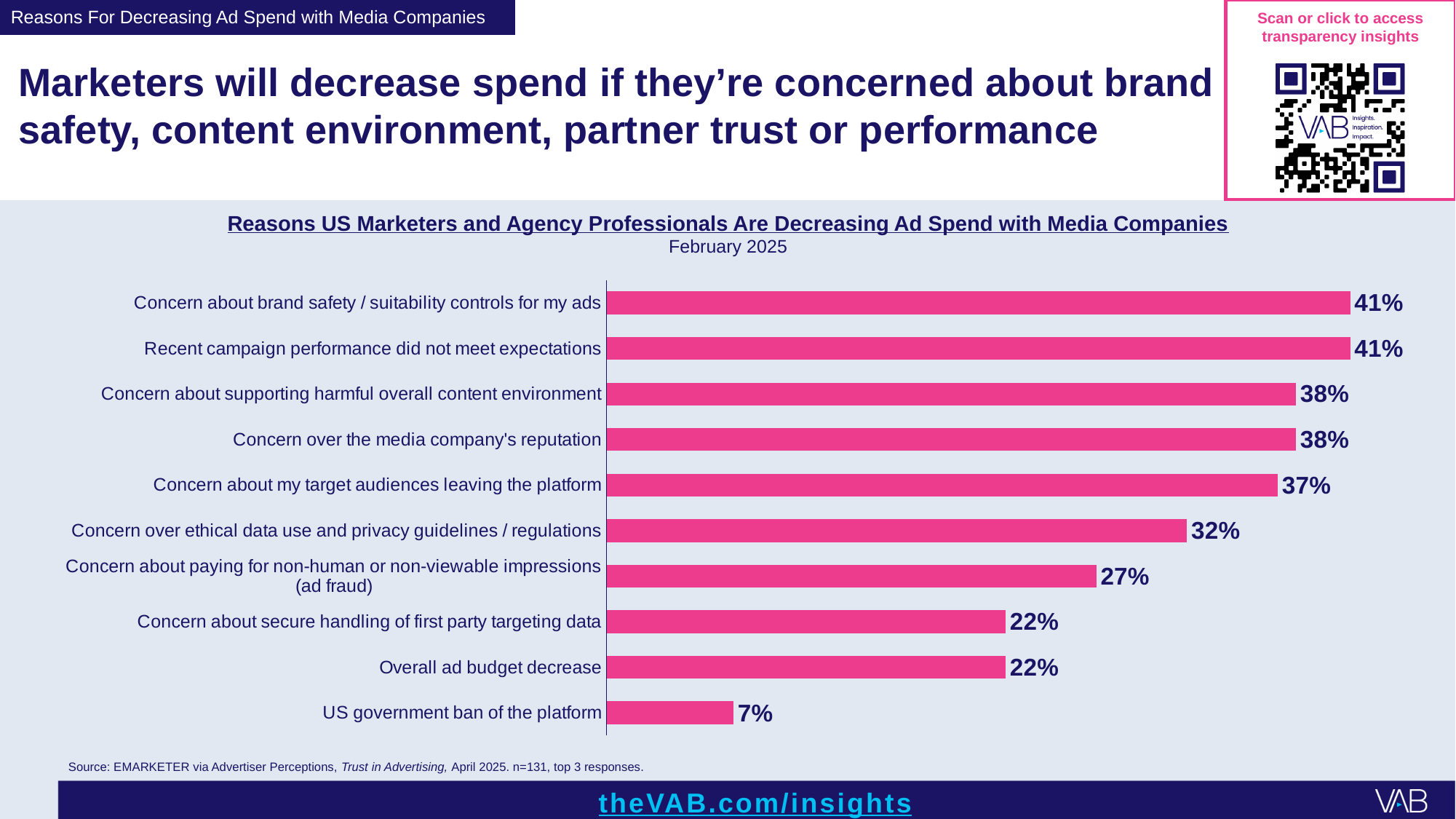
How many reasons (categories) are shown on the chart? 10 What is the value for 'Concern about paying for non-human or non-viewable impressions (ad fraud)'? 27% Which reason has the lowest value on the chart? US government ban of the platform What is the value for 'US government ban of the platform'? 7% What month and year does the chart's subtitle give for the data? February 2025 What kind of chart is shown on the slide? Bar chart What percentage of respondents cited concern about brand safety / suitability controls for my ads as a reason for decreasing ad spend? 41% How many reasons share the top value of 41%? 2 What is the difference between the value for 'Concern over ethical data use and privacy guidelines / regulations' and the value for 'Overall ad budget decrease'? 10% What is the difference between the highest value and the lowest value on the chart? 34% Which is larger: the value for 'Concern over the media company's reputation' or the value for 'Concern about secure handling of first party targeting data'? Concern over the media company's reputation What is the value for 'Concern about my target audiences leaving the platform'? 37%